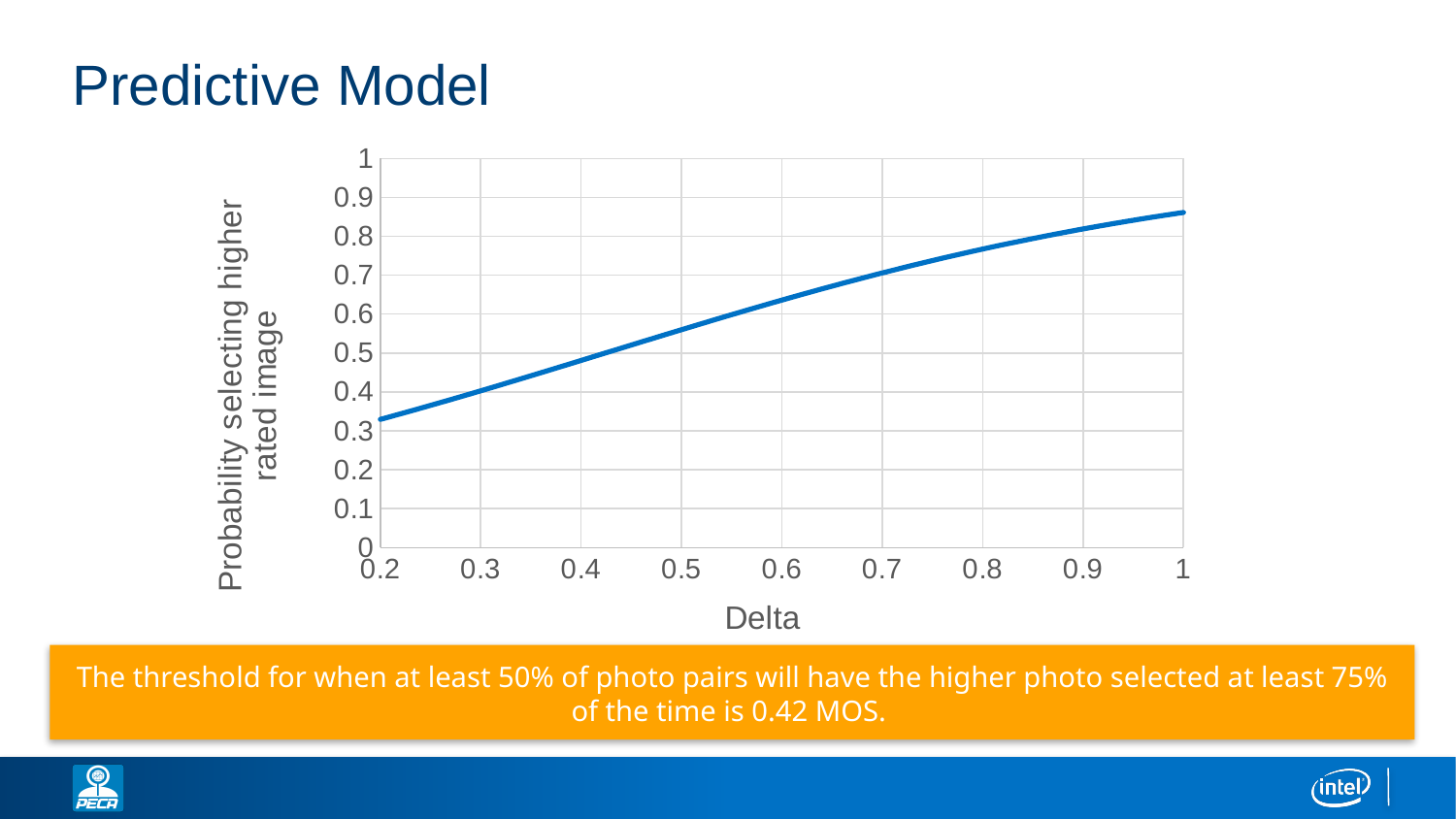
Is the probability at Delta 0.7 greater or less than 0.6? greater At which Delta value is the probability highest? 1 Is the probability at Delta 0.5 greater or less than 0.5? greater Which has the larger probability: Delta 0.3 or Delta 0.9? Delta 0.9 Is the probability at Delta 0.8 greater or less than 0.7? greater At which Delta value is the probability lowest? 0.2 Does the probability rise or fall as Delta increases along the x axis? rise What kind of chart is shown on the slide? line chart What is the label of the x axis? Delta